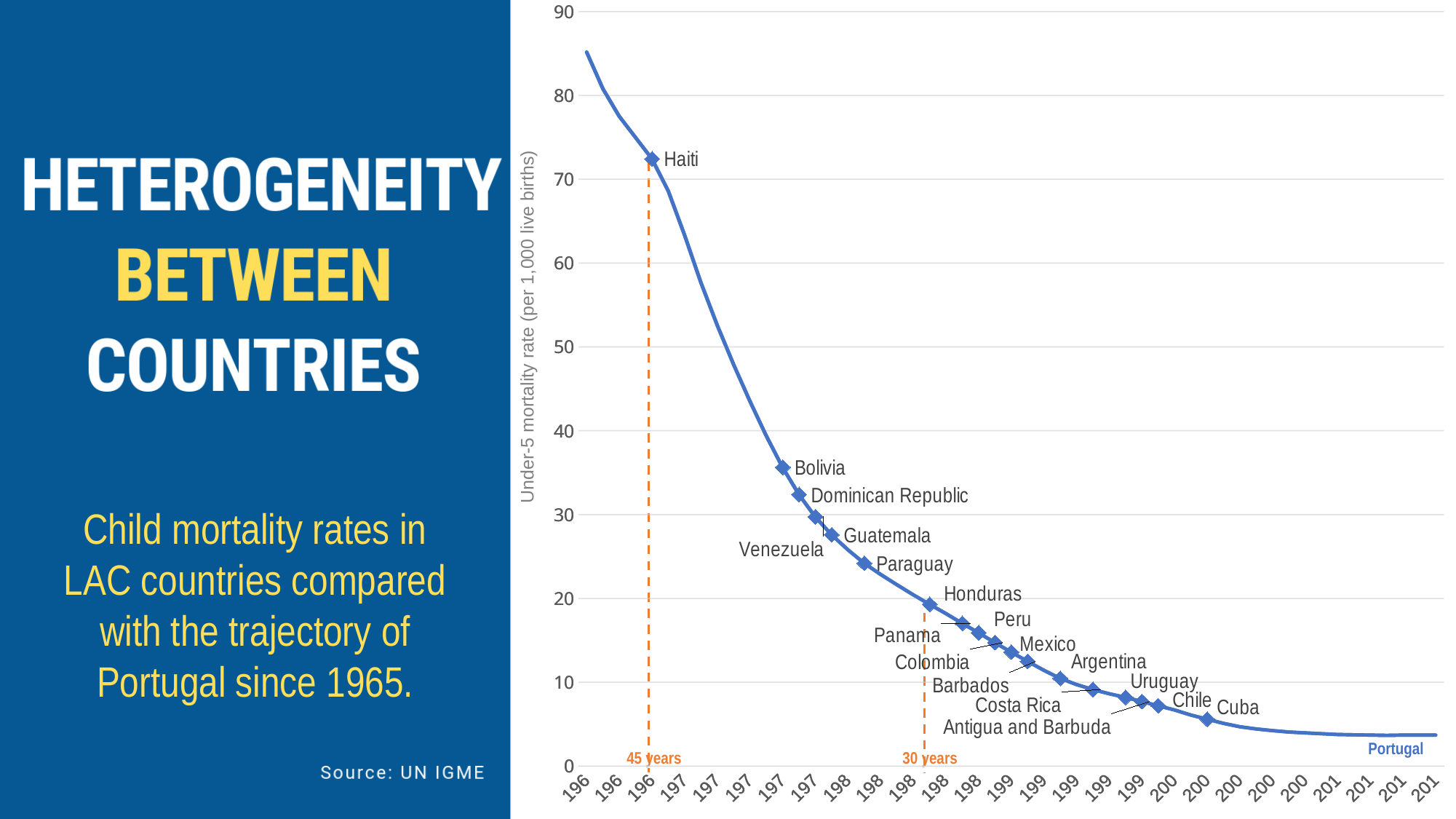
What is the label of the y axis? Under-5 mortality rate (per 1,000 live births) Is the value for Haiti greater or less than 70? greater Is the value for Bolivia greater or less than 40? less Is the value for Guatemala greater or less than 30? less Which has a higher under-5 mortality rate, Haiti or Bolivia? Haiti Does the Portugal line rise or fall along the x axis? fall Which labelled country has the highest under-5 mortality rate on the chart? Haiti What kind of chart is shown on the slide? line chart What labels are shown on the two orange dashed vertical lines? 45 years and 30 years